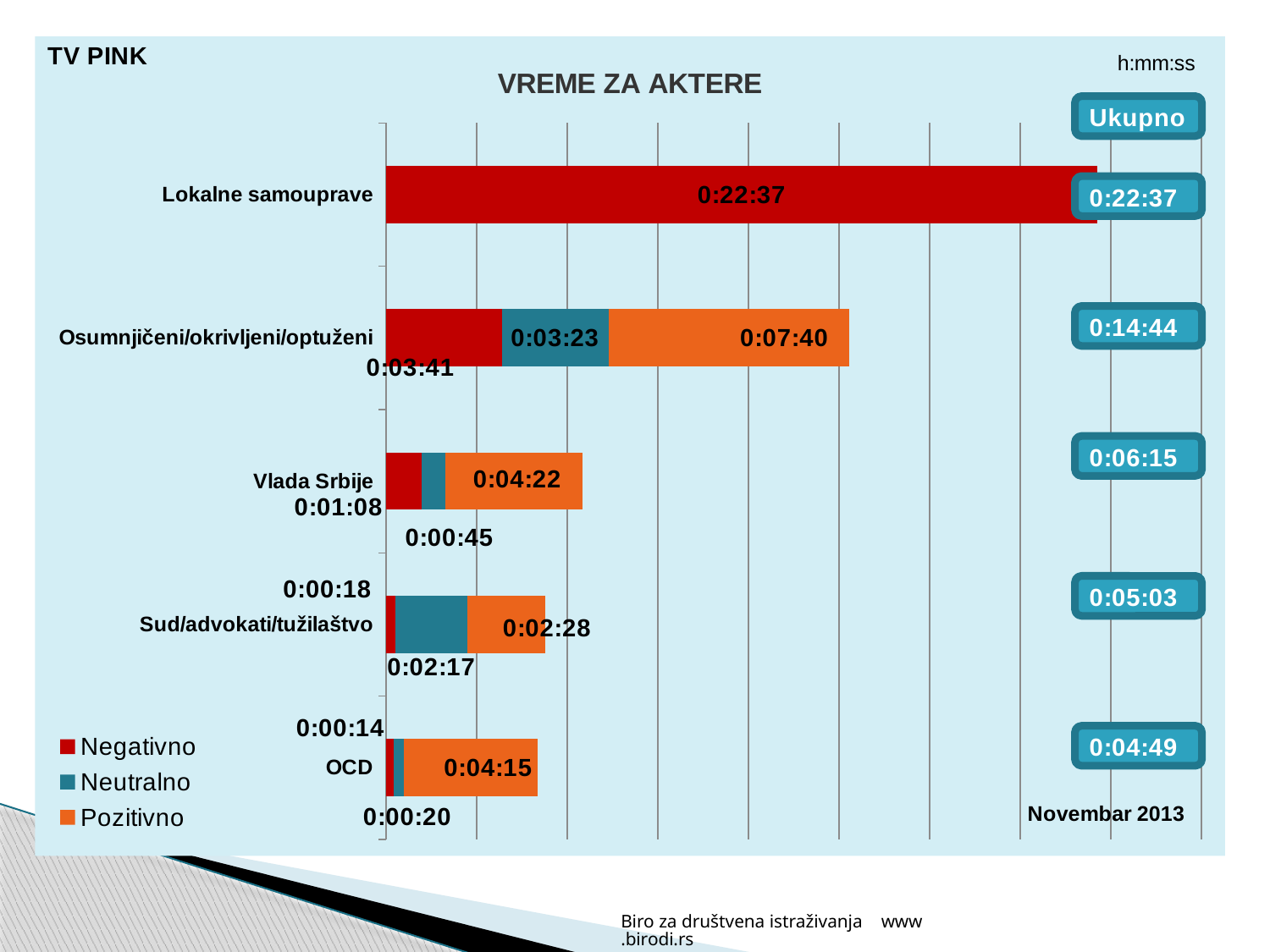
What is the total (Ukupno) time for Vlada Srbije? 0:06:15 Which category has the highest total time? Lokalne samouprave How many categories are shown on the chart? 5 What kind of chart is this? Stacked bar chart Which category has the lowest total time? OCD Which is larger: the Pozitivno value for Vlada Srbije or the Pozitivno value for OCD? Vlada Srbije How many series does the legend list? 3 What is the Negativno value for Lokalne samouprave? 0:22:37 What is the difference between the Pozitivno and Neutralno values for Osumnjičeni/okrivljeni/optuženi? 0:04:17 What is the Pozitivno value for Osumnjičeni/okrivljeni/optuženi? 0:07:40 What is the total (Ukupno) time for OCD? 0:04:49 What is the Neutralno value for Sud/advokati/tužilaštvo? 0:02:17